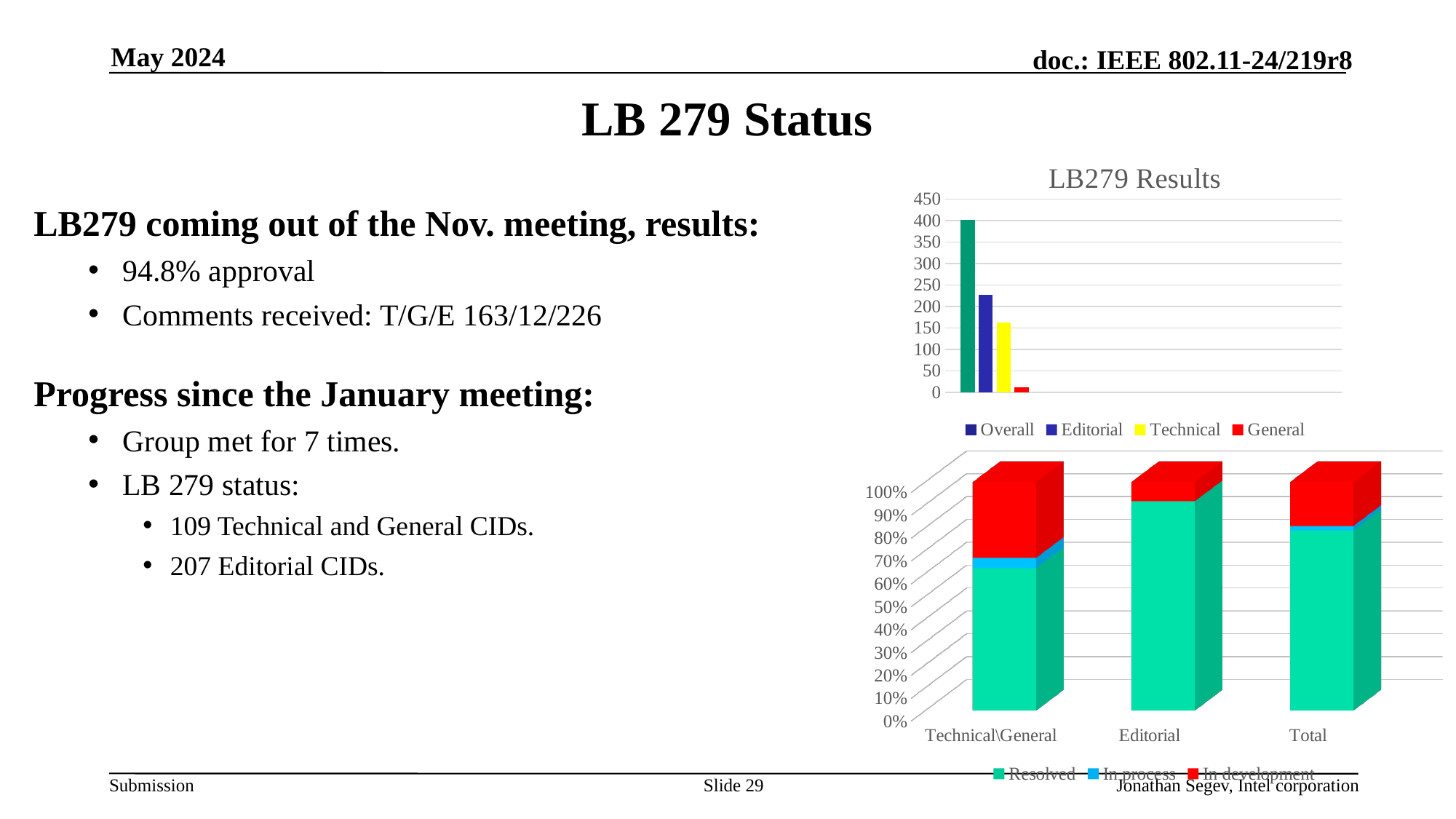
In the bottom stacked chart, how many categories are shown on the x axis? 3 What is the title of the top chart? LB279 Results In the 'LB279 Results' chart, which series has the highest value? Overall In the 'LB279 Results' chart, is the value for Technical greater or less than 200? less In the 'LB279 Results' chart, how many series does the legend list? 4 In the bottom stacked chart, how many series does the legend list? 3 In the 'LB279 Results' chart, is the value for Overall greater or less than 350? greater In the bottom stacked chart, which category has the largest Resolved share? Editorial In the 'LB279 Results' chart, is the value for Editorial greater or less than 200? greater In the 'LB279 Results' chart, which is larger, Editorial or Technical? Editorial In the 'LB279 Results' chart, what kind of chart is it? bar chart In the 'LB279 Results' chart, which series has the lowest value? General